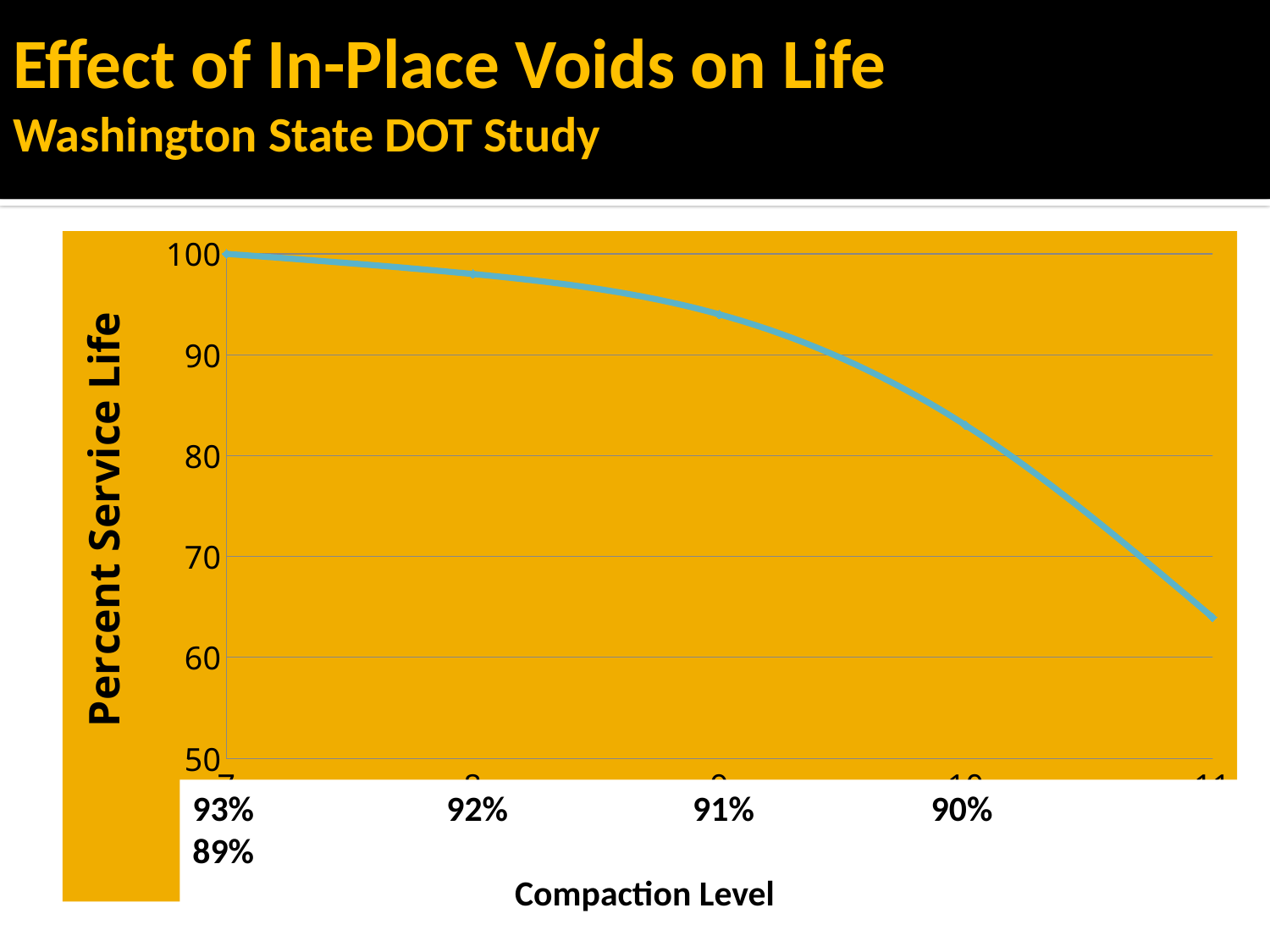
What kind of chart is shown on the slide? Line chart What is the label of the y axis? Percent Service Life Which compaction level has the higher percent service life, 92% or 89%? 92% Is the percent service life at a compaction level of 90% greater or less than 90? less Is the percent service life at a compaction level of 91% greater or less than 90? greater What is the percent service life at a compaction level of 93%? 100 Does the percent service life rise or fall as the compaction level goes from 93% to 89%? Fall At which compaction level is the percent service life lowest? 89% Is the percent service life at a compaction level of 89% greater or less than 70? less What is the label of the x axis? Compaction Level At which compaction level is the percent service life highest? 93%